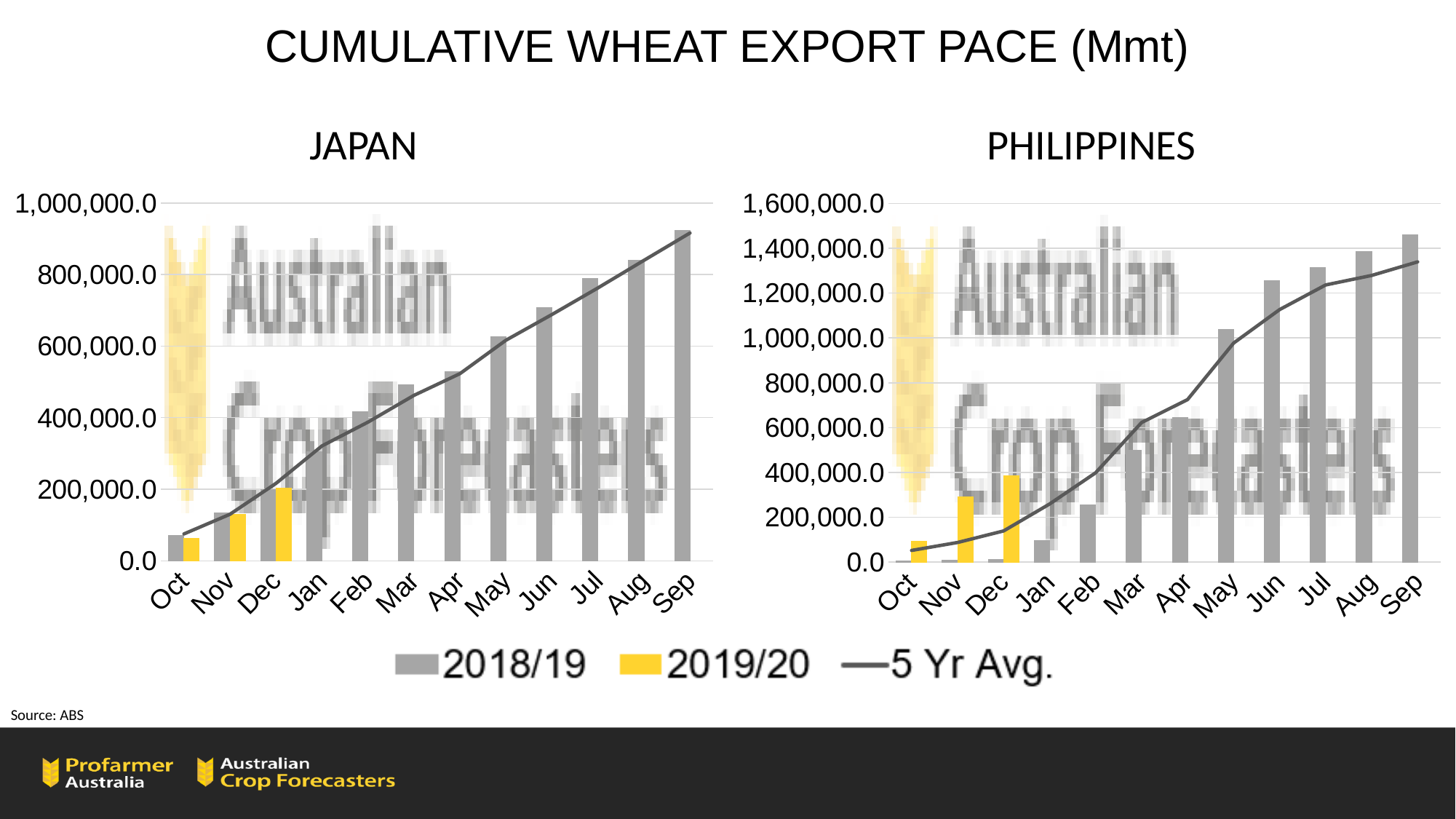
What kind of chart is the JAPAN chart? Bar chart with a line In the PHILIPPINES chart, is the 2019/20 value for Dec greater or less than 200,000.0? greater In the PHILIPPINES chart, which is larger for Dec: the 2018/19 value or the 2019/20 value? 2019/20 In the JAPAN chart, does the 5 Yr Avg line rise or fall from Oct to Sep? Rise In the JAPAN chart, is the 2019/20 value for Nov greater or less than 200,000.0? less What colour are the 2019/20 bars? Yellow In the JAPAN chart, which month has the highest 2018/19 bar? Sep In the PHILIPPINES chart, is the 2018/19 value for Sep greater or less than 1,200,000.0? greater How many series does the legend list? 3 How many months are shown on the x axis of the PHILIPPINES chart? 12